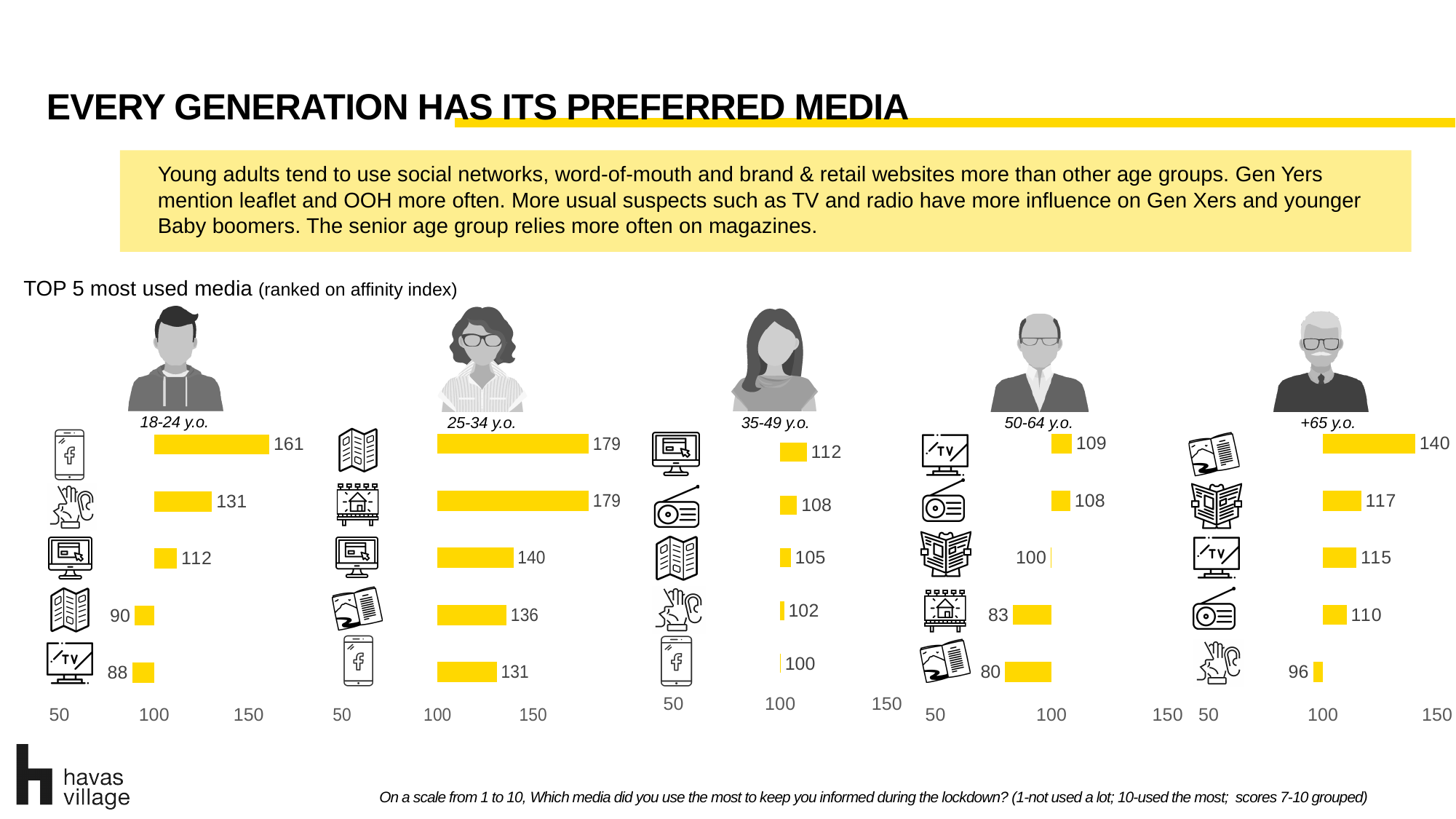
Which is larger: the top bar of the 35-49 y.o. chart or the top bar of the +65 y.o. chart? The top bar of the +65 y.o. chart (140) In the 35-49 y.o. chart, what is the value of the second bar from the top? 108 In the 25-34 y.o. chart, is the value of the top bar greater or less than 150? greater What is the lowest value shown in the 50-64 y.o. chart? 80 In the 18-24 y.o. chart, what is the difference between the top bar (161) and the second bar (131)? 30 How many bars are shown in the 50-64 y.o. chart? 5 What is the highest value shown in the 18-24 y.o. chart? 161 In the 18-24 y.o. chart, what is the value of the top (first) bar? 161 In the +65 y.o. chart, what is the value of the bottom (fifth) bar? 96 What kind of chart is used for each age group on this slide? Bar chart In the 50-64 y.o. chart, do the values increase or decrease from the top bar to the bottom bar? decrease How many age-group charts are shown on the slide? 5